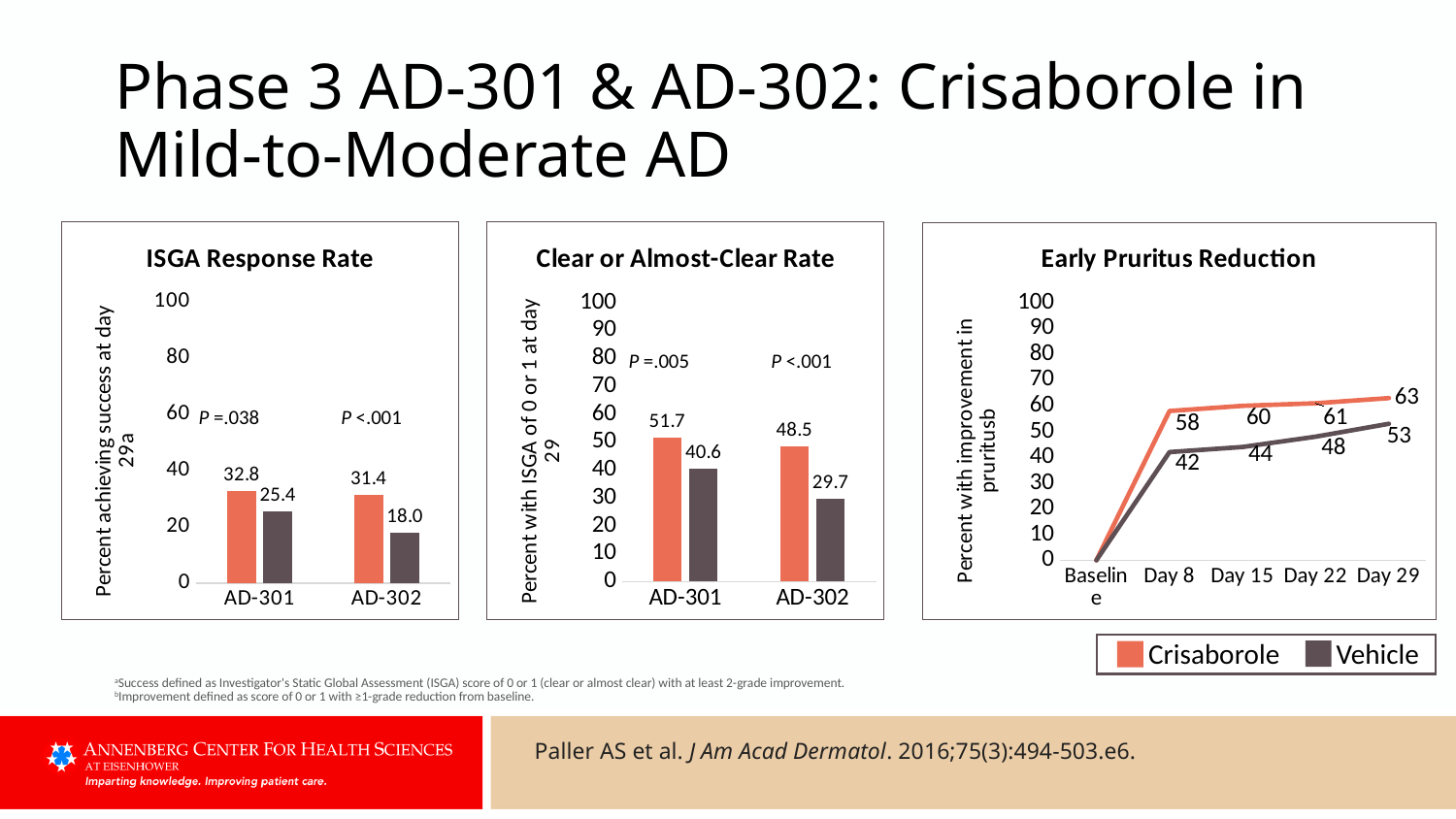
In the Clear or Almost-Clear Rate chart, what is the value for Vehicle in AD-301? 40.6 How many series does the legend list? 2 In the ISGA Response Rate chart, what is the value for Crisaborole in AD-301? 32.8 In the ISGA Response Rate chart, what is the value for Vehicle in AD-302? 18.0 What kind of chart is the Early Pruritus Reduction chart? line chart In the Clear or Almost-Clear Rate chart, which is larger: Crisaborole in AD-302 or Vehicle in AD-301? Crisaborole in AD-302 In the Early Pruritus Reduction chart, does the Vehicle line rise or fall from Day 8 to Day 29? rise In the ISGA Response Rate chart, what is the difference between Crisaborole and Vehicle in AD-302? 13.4 In the Early Pruritus Reduction chart, what is the value for Vehicle at Day 22? 48 In the Clear or Almost-Clear Rate chart, which bar is the highest? Crisaborole in AD-301 In the Early Pruritus Reduction chart, what is the value for Crisaborole at Day 29? 63 In the Clear or Almost-Clear Rate chart, what is the difference between Crisaborole and Vehicle in AD-302? 18.8